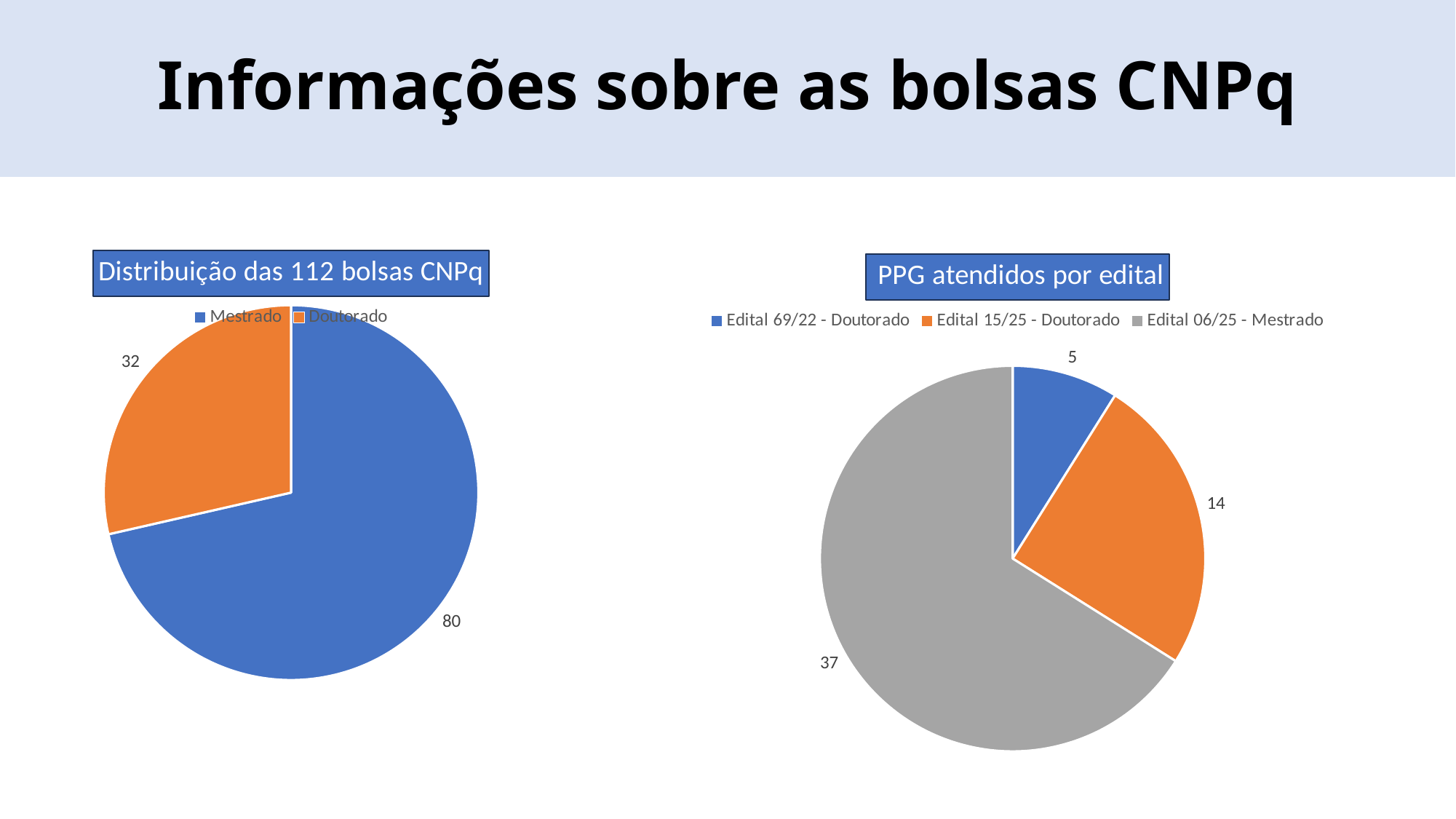
In the chart titled "Distribuição das 112 bolsas CNPq", how many bolsas are for Mestrado? 80 In the chart titled "PPG atendidos por edital", what share of the total does Edital 15/25 - Doutorado represent? 25% In the chart titled "PPG atendidos por edital", what is the value for Edital 06/25 - Mestrado? 37 In the chart titled "PPG atendidos por edital", which edital has the smallest value? Edital 69/22 - Doutorado What kind of chart is the chart titled "Distribuição das 112 bolsas CNPq"? Pie chart In the chart titled "PPG atendidos por edital", how many categories does the legend list? 3 In the chart titled "PPG atendidos por edital", what is the value for Edital 15/25 - Doutorado? 14 In the chart titled "Distribuição das 112 bolsas CNPq", what is the difference between the Mestrado and Doutorado values? 48 In the chart titled "PPG atendidos por edital", which colour is used for Edital 06/25 - Mestrado? Grey In the chart titled "Distribuição das 112 bolsas CNPq", which category has the larger slice? Mestrado In the chart titled "PPG atendidos por edital", what is the total of all slices? 56 In the chart titled "Distribuição das 112 bolsas CNPq", how many bolsas are for Doutorado? 32